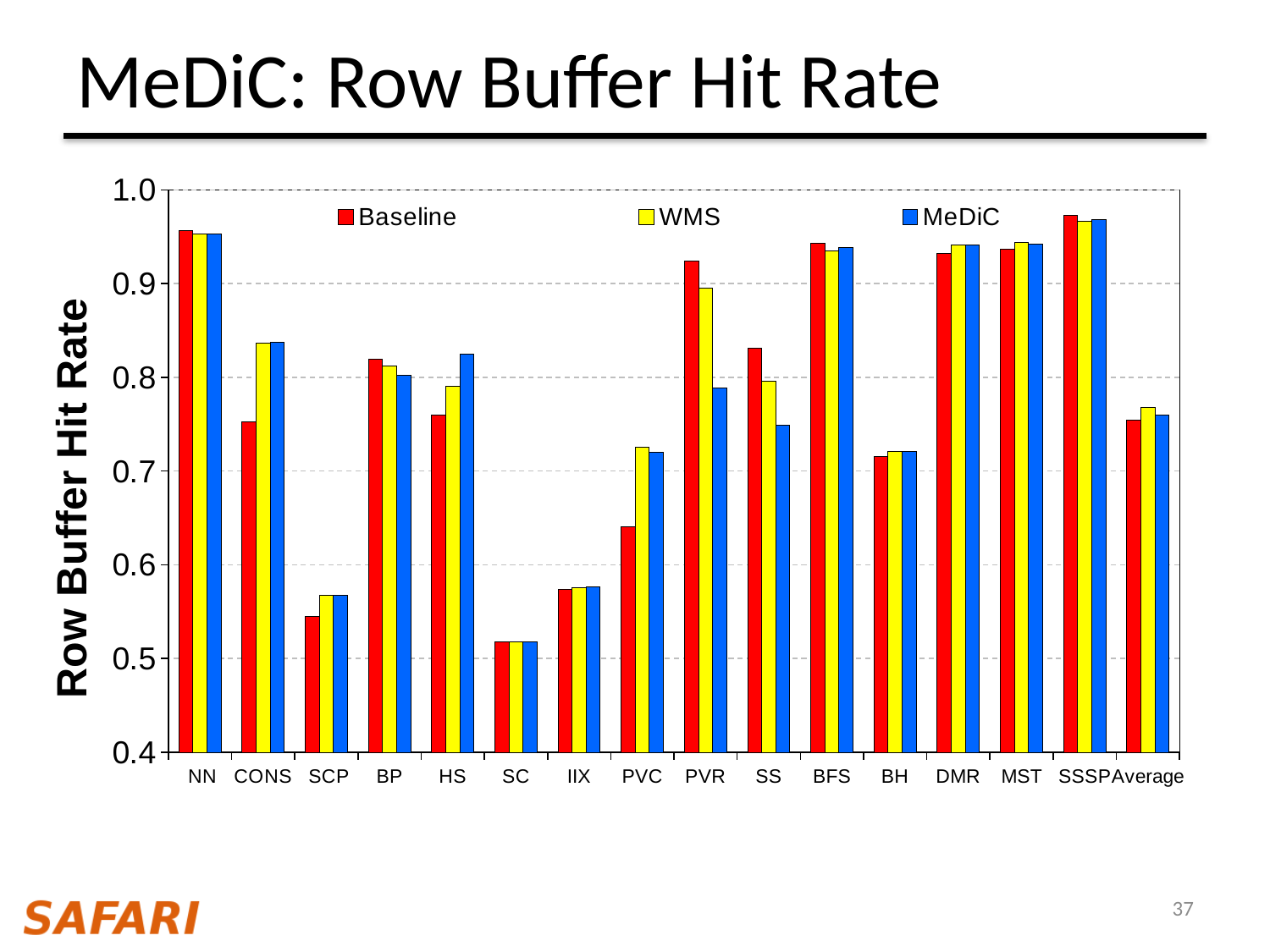
What is the label of the y axis? Row Buffer Hit Rate Is the MeDiC value for HS greater or less than 0.8? greater What kind of chart is shown on the slide? bar chart Which category has the lowest Baseline row buffer hit rate? SC Is the Baseline value for PVR greater or less than 0.9? greater Is the WMS value for SCP greater or less than 0.6? less For PVR, which is larger: the Baseline value or the MeDiC value? Baseline How many series does the legend list? 3 For CONS, which is larger: the Baseline value or the MeDiC value? MeDiC Which category has the highest MeDiC row buffer hit rate? SSSP How many categories are shown on the x axis? 16